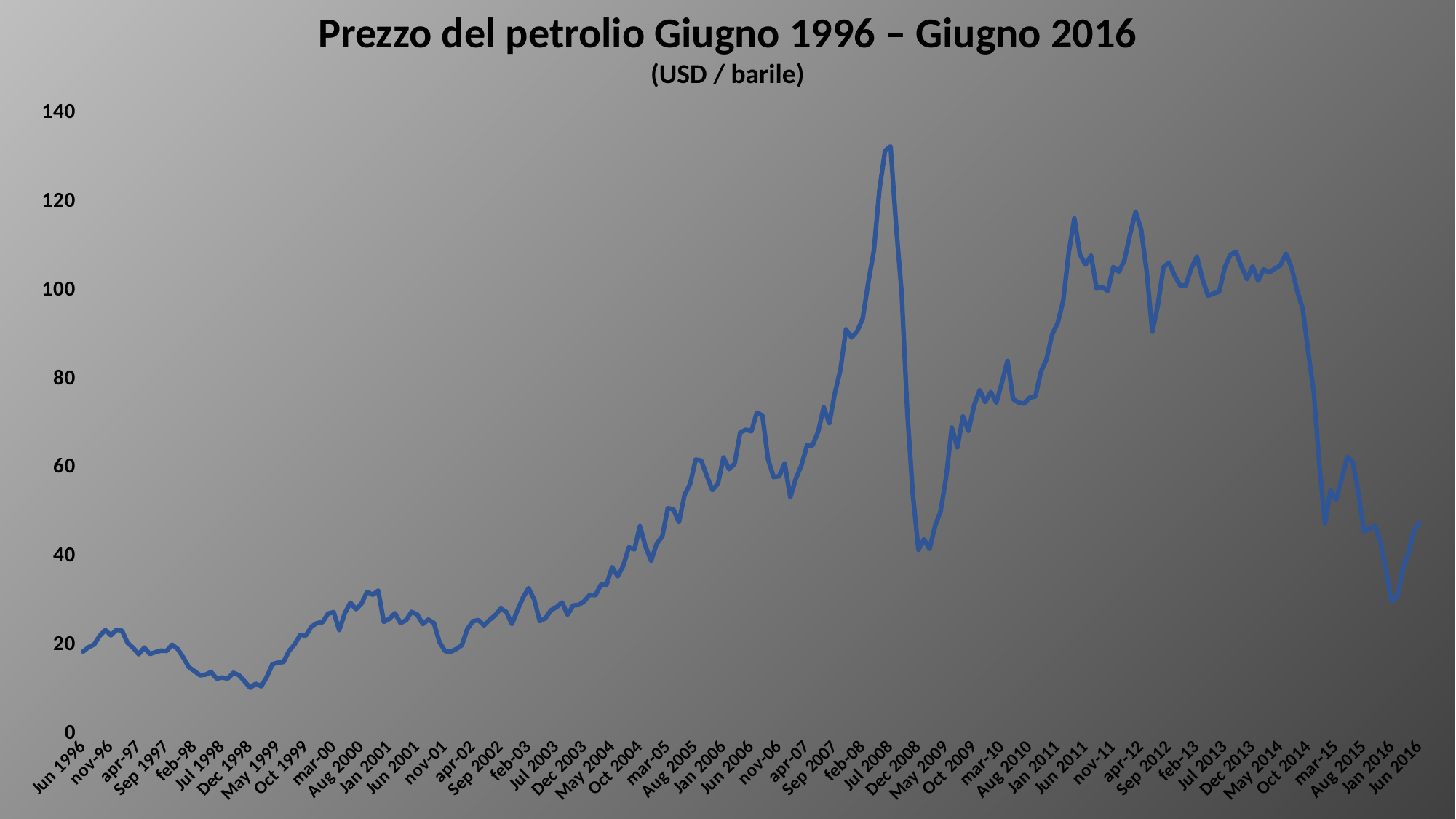
Is the value at Dec 1998 greater or less than 20? less How many data series are plotted on the chart? 1 Around which labelled period does the oil price reach its highest point? Jul 2008 In what unit are the values on the chart expressed, according to the subtitle? USD / barile Which is higher, the value at Jun 2011 or the value at Jun 2016? Jun 2011 Is the value at Jun 2016 greater or less than 40? greater Does the oil price rise or fall between Jul 2008 and Dec 2008? fall Is the value at Jun 2011 greater or less than 100? greater Around which labelled period does the oil price reach its lowest point? Dec 1998 What is the title of the chart? Prezzo del petrolio Giugno 1996 – Giugno 2016 What kind of chart is shown on the slide? line chart